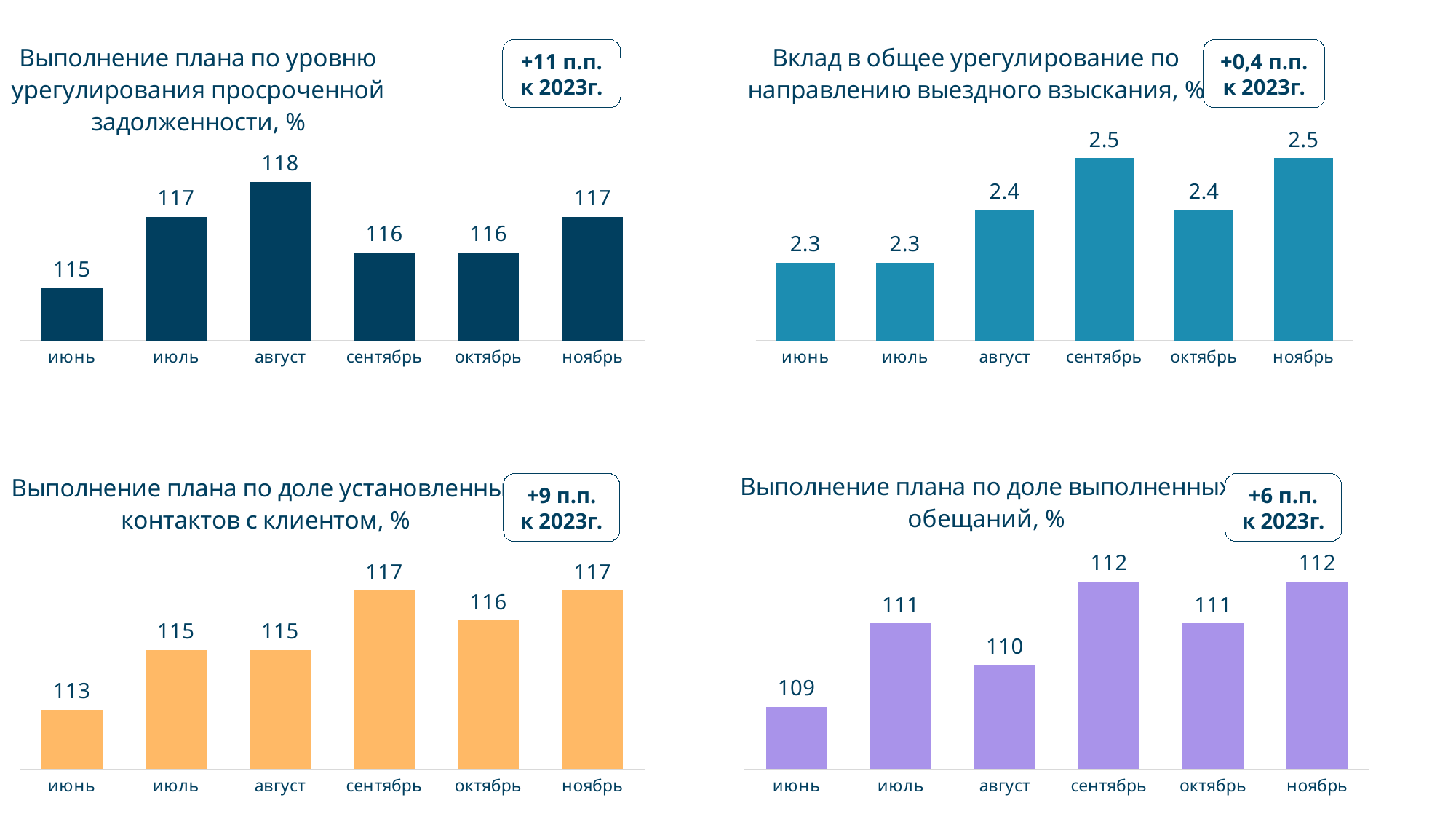
In the top-left chart, which month has the lowest value? июнь In the top-right chart, what is the value for сентябрь? 2.5 What type of chart is the bottom-right chart? bar chart In the top-left chart, what is the value for август? 118 In the top-left chart, what is the difference between the values for август and июнь? 3 In the bottom-left chart, what is the value for июнь? 113 In the bottom-right chart, what is the value for август? 110 In the bottom-right chart, which month has the lowest value? июнь What change versus 2023 is shown in the box next to the bottom-left chart? +9 п.п. к 2023г. In the top-right chart, how many months are shown on the x axis? 6 In the bottom-left chart, which is larger, the value for сентябрь or the value for октябрь? сентябрь In the top-right chart, what is the difference between the values for ноябрь and июнь? 0.2